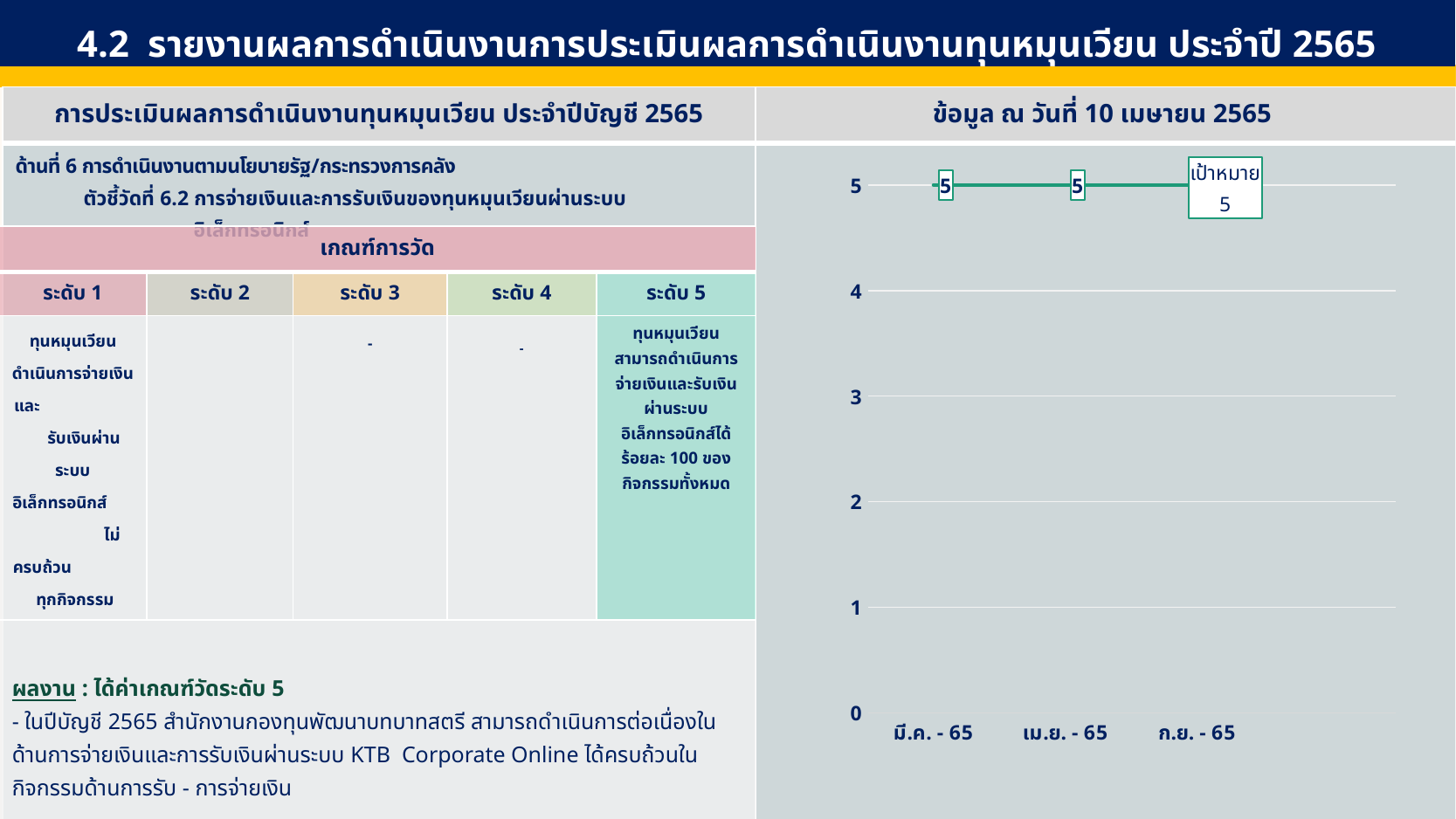
Is the value for เม.ย. - 65 greater or less than 4? greater What is the highest value shown on the y axis of the chart? 5 How many categories are shown on the x axis of the chart? 3 Is the value for มี.ค. - 65 greater or less than 3? greater Does the plotted line rise, fall, or stay flat from มี.ค. - 65 to เม.ย. - 65? stays flat What is the difference between the values for มี.ค. - 65 and เม.ย. - 65? 0 What is the value plotted for มี.ค. - 65? 5 What is the value plotted for เม.ย. - 65? 5 What kind of chart is shown on the right side of the slide? line chart What is the value shown in the เป้าหมาย (target) box at ก.ย. - 65? 5 What is the label of the last category on the x axis? ก.ย. - 65